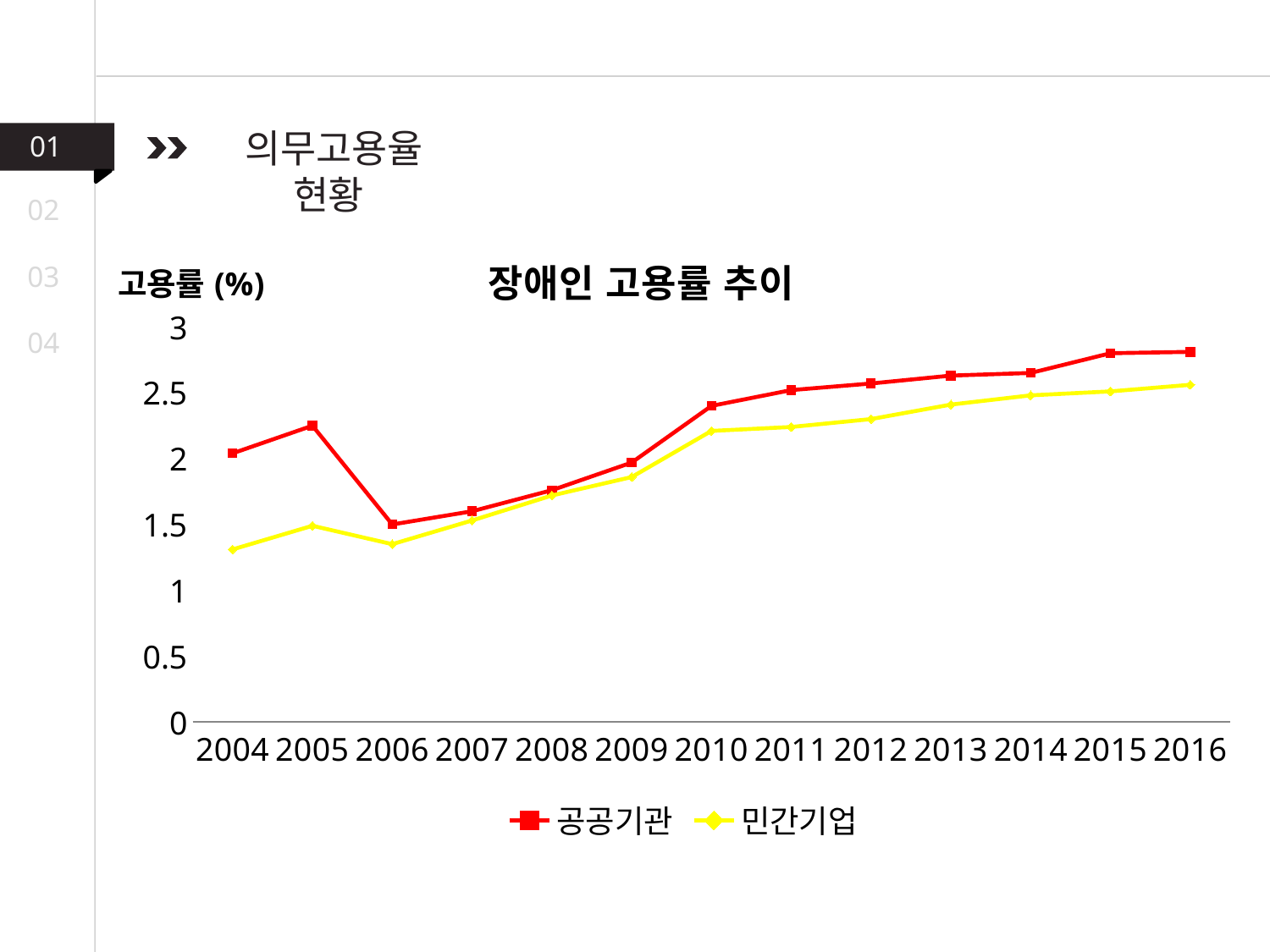
How many series does the legend list? 2 Which series is drawn in red? 공공기관 What kind of chart is shown on the slide? line chart Is the value for 민간기업 in 2004 greater or less than 1.5? less In which year is the value for 공공기관 lowest? 2006 What is the title of the chart? 장애인 고용률 추이 How many years are shown on the x axis? 13 Which series has the larger value in 2004, 공공기관 or 민간기업? 공공기관 In which year is the value for 민간기업 lowest? 2004 Do the values for 민간기업 rise or fall from 2006 to 2016? rise Is the value for 공공기관 in 2016 greater or less than 2.5? greater Is the value for 공공기관 in 2005 greater or less than 2? greater